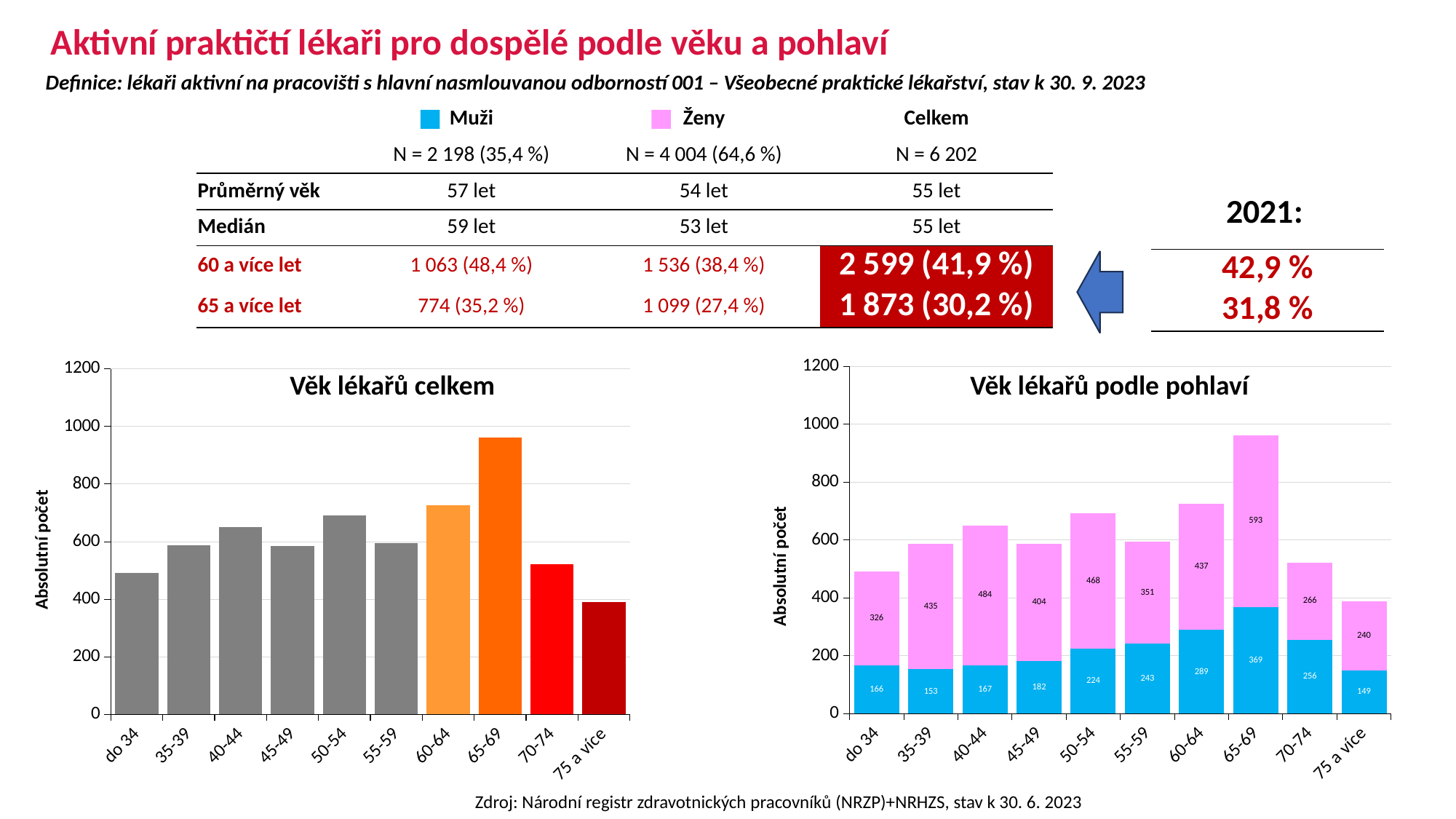
What kind of chart is the 'Věk lékařů celkem' chart? bar chart In the 'Věk lékařů podle pohlaví' chart, what is the difference between the Ženy and Muži values in the '65-69' category? 224 In the 'Věk lékařů podle pohlaví' chart, what is the total of the stacked bar for '65-69'? 962 In the 'Věk lékařů podle pohlaví' chart, what is the value for Ženy in the '65-69' category? 593 In the 'Věk lékařů podle pohlaví' chart, which category has the lowest Muži value? 75 a více In the 'Věk lékařů celkem' chart, is the value for 'do 34' greater or less than 600? less In the 'Věk lékařů podle pohlaví' chart, is the Ženy value larger for '50-54' or for '55-59'? 50-54 In the 'Věk lékařů celkem' chart, is the value for '65-69' greater or less than 800? greater In the 'Věk lékařů podle pohlaví' chart, what is the value for Muži in the 'do 34' category? 166 How many age categories are shown on the x axis of the 'Věk lékařů celkem' chart? 10 In the 'Věk lékařů celkem' chart, which age category has the highest value? 65-69 In the 'Věk lékařů celkem' chart, which age category has the lowest value? 75 a více